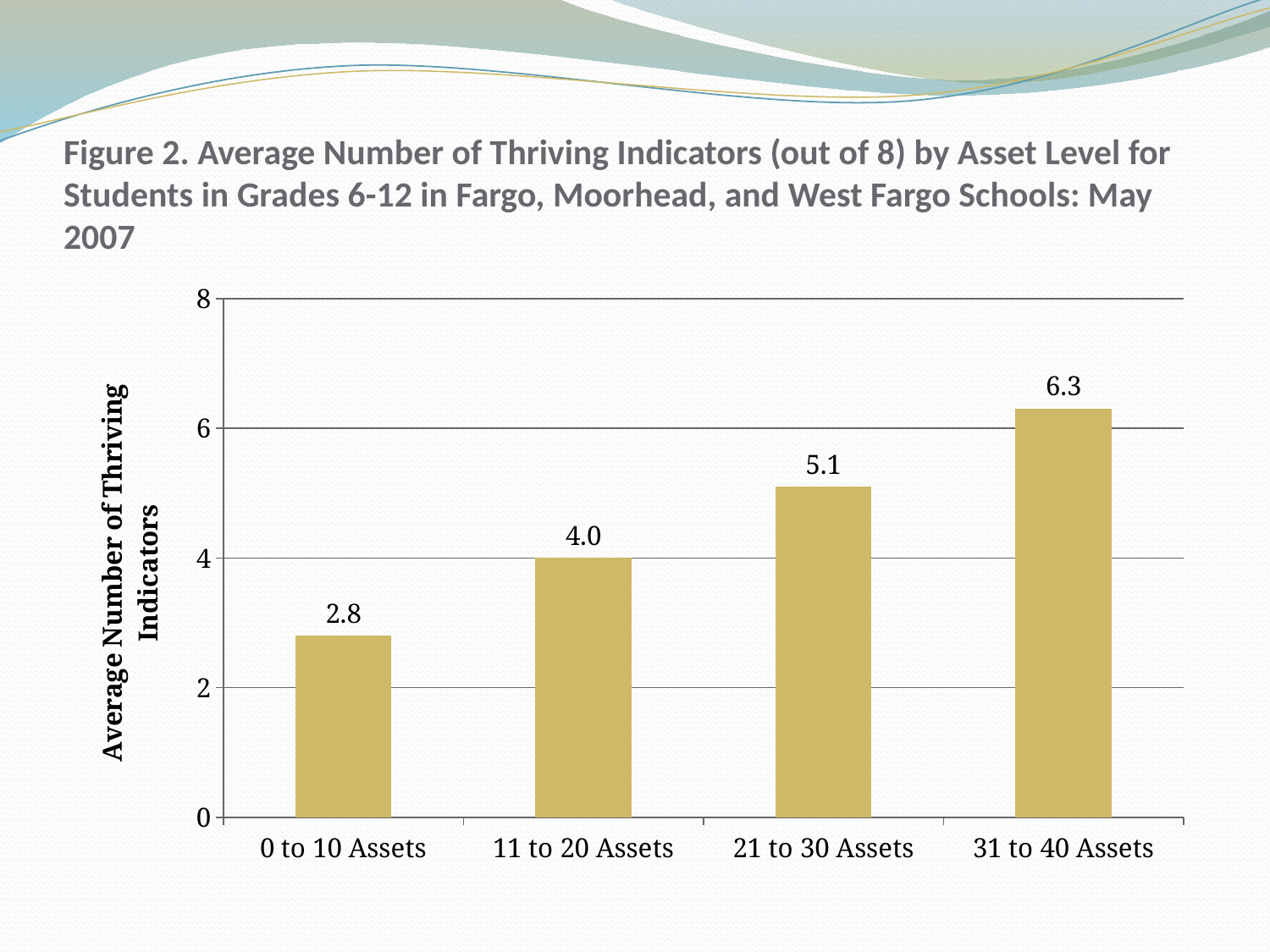
What is the average number of thriving indicators for students with 21 to 30 Assets? 5.1 What is the average number of thriving indicators for students with 0 to 10 Assets? 2.8 Which asset level has the lowest average number of thriving indicators? 0 to 10 Assets What is the difference in average thriving indicators between the 31 to 40 Assets group and the 0 to 10 Assets group? 3.5 What is the average number of thriving indicators for students with 31 to 40 Assets? 6.3 Which group has a higher average number of thriving indicators: 11 to 20 Assets or 21 to 30 Assets? 21 to 30 Assets How many asset level categories are shown in the chart? 4 What is the average number of thriving indicators for students with 11 to 20 Assets? 4.0 What kind of chart is shown on the slide? Bar chart Is the value for 21 to 30 Assets greater or less than 6? less Which asset level has the highest average number of thriving indicators? 31 to 40 Assets Do the values rise or fall as the asset level increases along the x axis? Rise